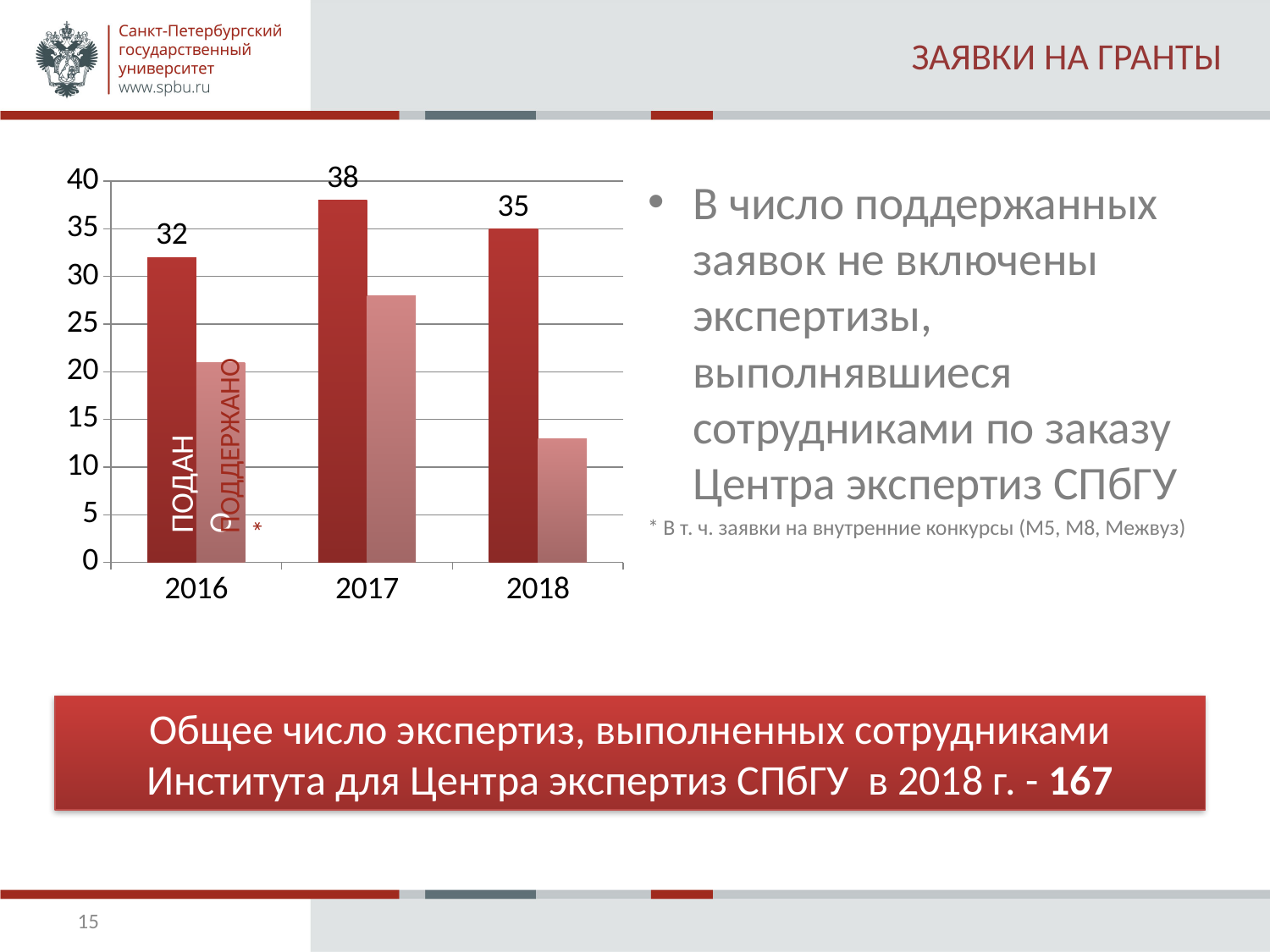
In which year was the number of submitted (ПОДАНО) applications lowest? 2016 Which year has more submitted (ПОДАНО) applications, 2016 or 2018? 2018 What is the value of the ПОДАНО bar for 2018? 35 What type of chart is used to show the grant applications? bar chart How many years are shown on the x axis of the chart? 3 In which year was the number of submitted (ПОДАНО) applications highest? 2017 Is the ПОДДЕРЖАНО value for 2017 greater or less than 25? greater Is the ПОДДЕРЖАНО value for 2018 greater or less than 15? less How many submitted (ПОДАНО) grant applications are shown for 2016? 32 What is the difference between the ПОДАНО values for 2017 and 2018? 3 By how much did the number of submitted (ПОДАНО) applications increase from 2016 to 2017? 6 What is the value of the ПОДАНО bar for 2017? 38